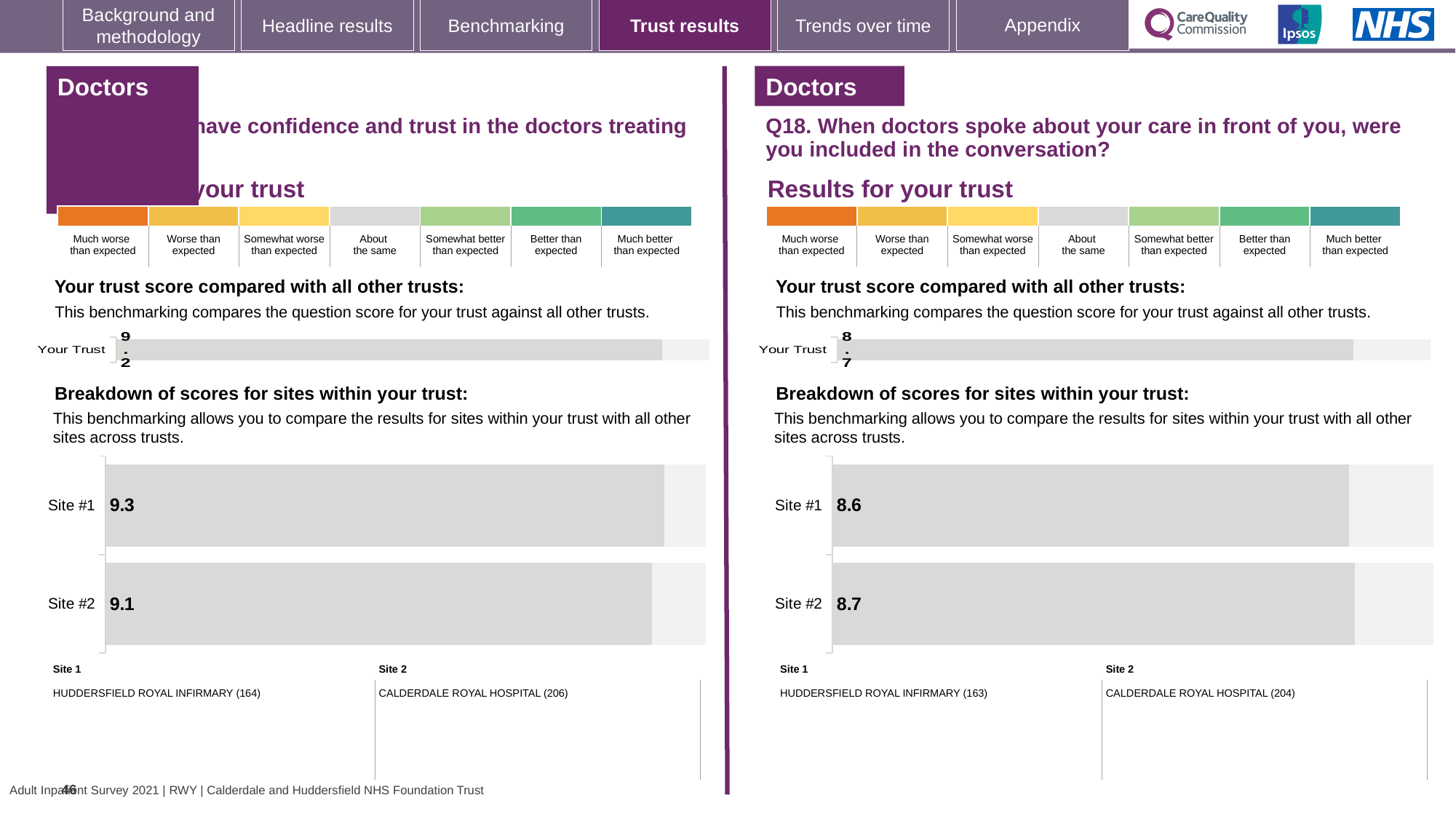
In the Q18 section on the right-hand side, what is the score shown for Site #2? 8.7 How many sites are shown in the breakdown of scores chart in the Q18 section on the right-hand side? 2 In the Q18 section on the right-hand side, what is the 'Your Trust' score in the chart comparing the trust with all other trusts? 8.7 On the left-hand side of the slide, what is the difference between the Site #1 and Site #2 scores? 0.2 On the left-hand side of the slide, what is the score shown for Site #2 in the breakdown of scores for sites within your trust? 9.1 On the left-hand side of the slide, which site has the higher score in the breakdown of scores for sites within your trust? Site #1 In the Q18 section on the right-hand side, what is the difference between the Site #2 and Site #1 scores? 0.1 In the Q18 section on the right-hand side, what is the score shown for Site #1? 8.6 On the left-hand side of the slide, what is the 'Your Trust' score in the chart comparing the trust with all other trusts? 9.2 What type of chart is used to show the breakdown of scores for sites within your trust on the left-hand side of the slide? Bar chart In the Q18 section on the right-hand side, which site has the lower score in the breakdown of scores for sites within your trust? Site #1 On the left-hand side of the slide, what is the score shown for Site #1 in the breakdown of scores for sites within your trust? 9.3